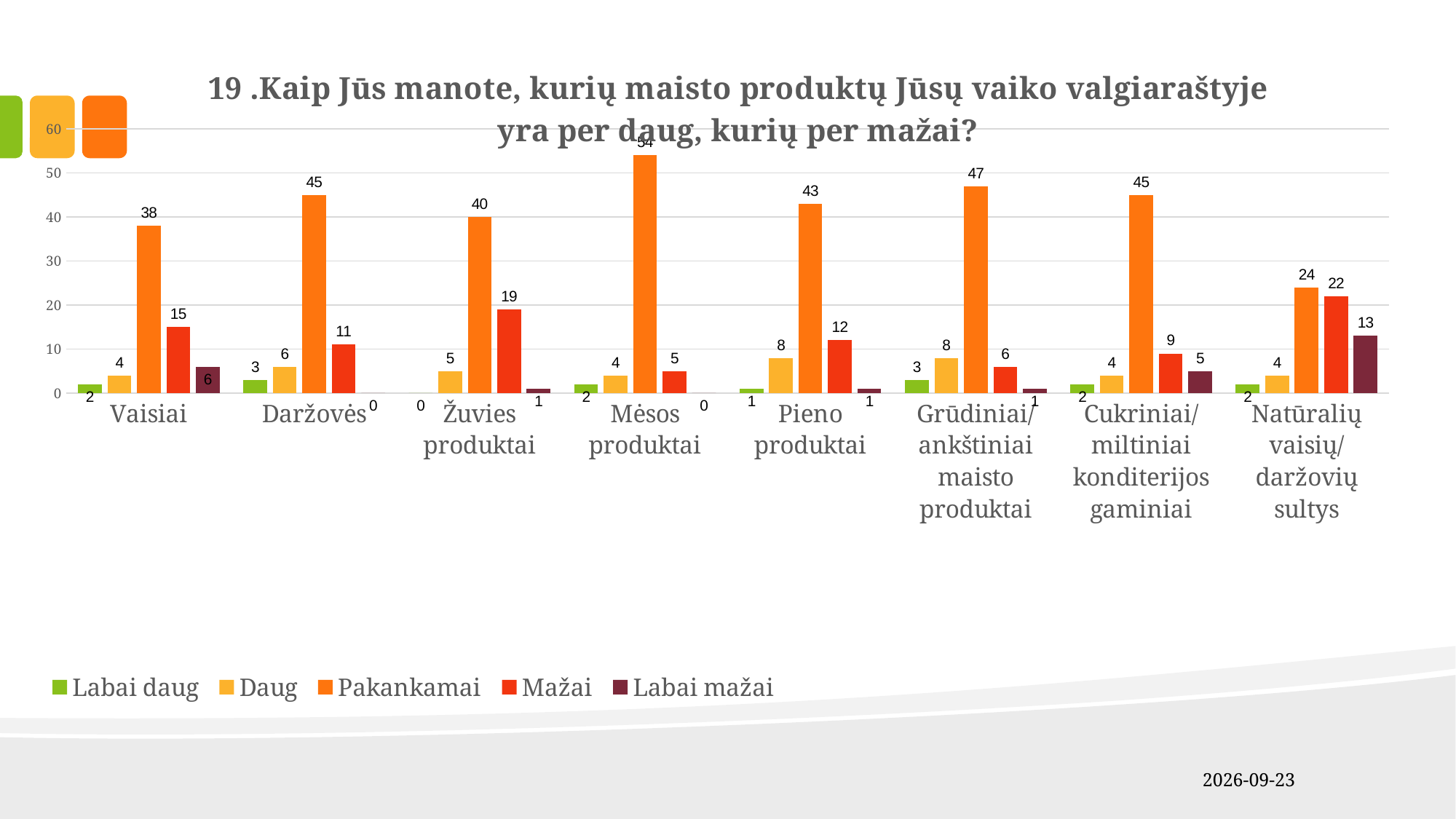
How many series does the legend list? 5 Which series is shown in green in the legend? Labai daug How many categories are shown on the x axis? 8 Which category has the highest Pakankamai value? Mėsos produktai What is the value of Pakankamai for Mėsos produktai? 54 What is the value of Labai mažai for Natūralių vaisių/daržovių sultys? 13 What is the difference between the Pakankamai values for Mėsos produktai and Vaisiai? 16 What is the value of Mažai for Žuvies produktai? 19 Which is larger: the Mažai value for Vaisiai or the Mažai value for Daržovės? Vaisiai What kind of chart is shown on the slide? Bar chart Which category has the lowest Pakankamai value? Natūralių vaisių/daržovių sultys What is the value of Daug for Pieno produktai? 8